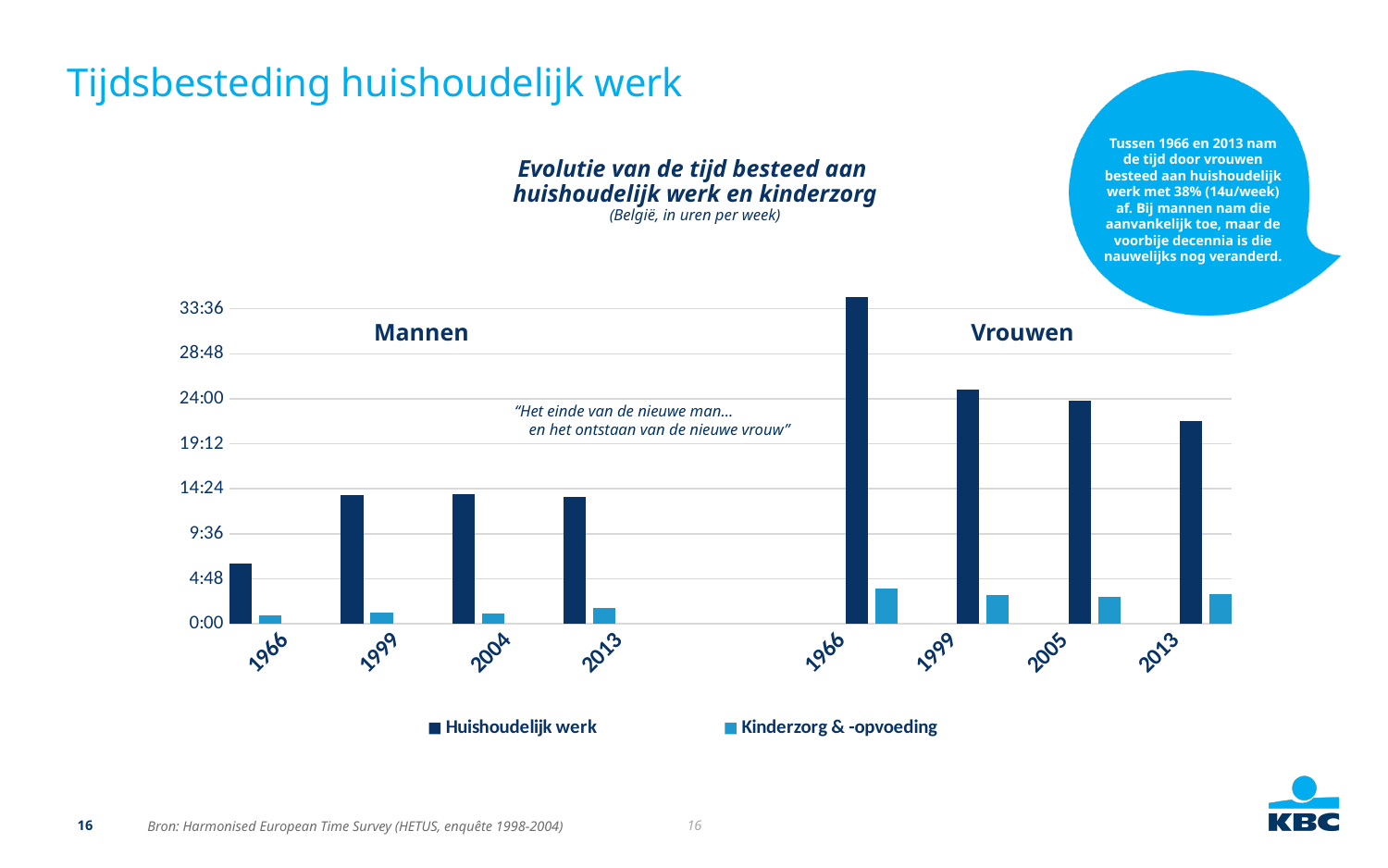
Which group and year has the lowest Huishoudelijk werk bar? Mannen 1966 How many year categories are plotted on the x axis in total (Mannen and Vrouwen combined)? 8 What kind of chart is shown on the slide? bar chart How many series does the legend list? 2 Do the Huishoudelijk werk values for Vrouwen rise or fall from 1966 to 2013? fall What are the two series named in the legend? Huishoudelijk werk; Kinderzorg & -opvoeding Is the Huishoudelijk werk value for Mannen in 1999 greater or less than 9:36? greater Is the Huishoudelijk werk value for Mannen in 1966 greater or less than 9:36? less Is the Huishoudelijk werk value for Vrouwen in 2013 greater or less than 24:00? less Which is larger, the Huishoudelijk werk value for Vrouwen in 1966 or for Mannen in 1966? Vrouwen 1966 Which group and year has the highest Huishoudelijk werk bar? Vrouwen 1966